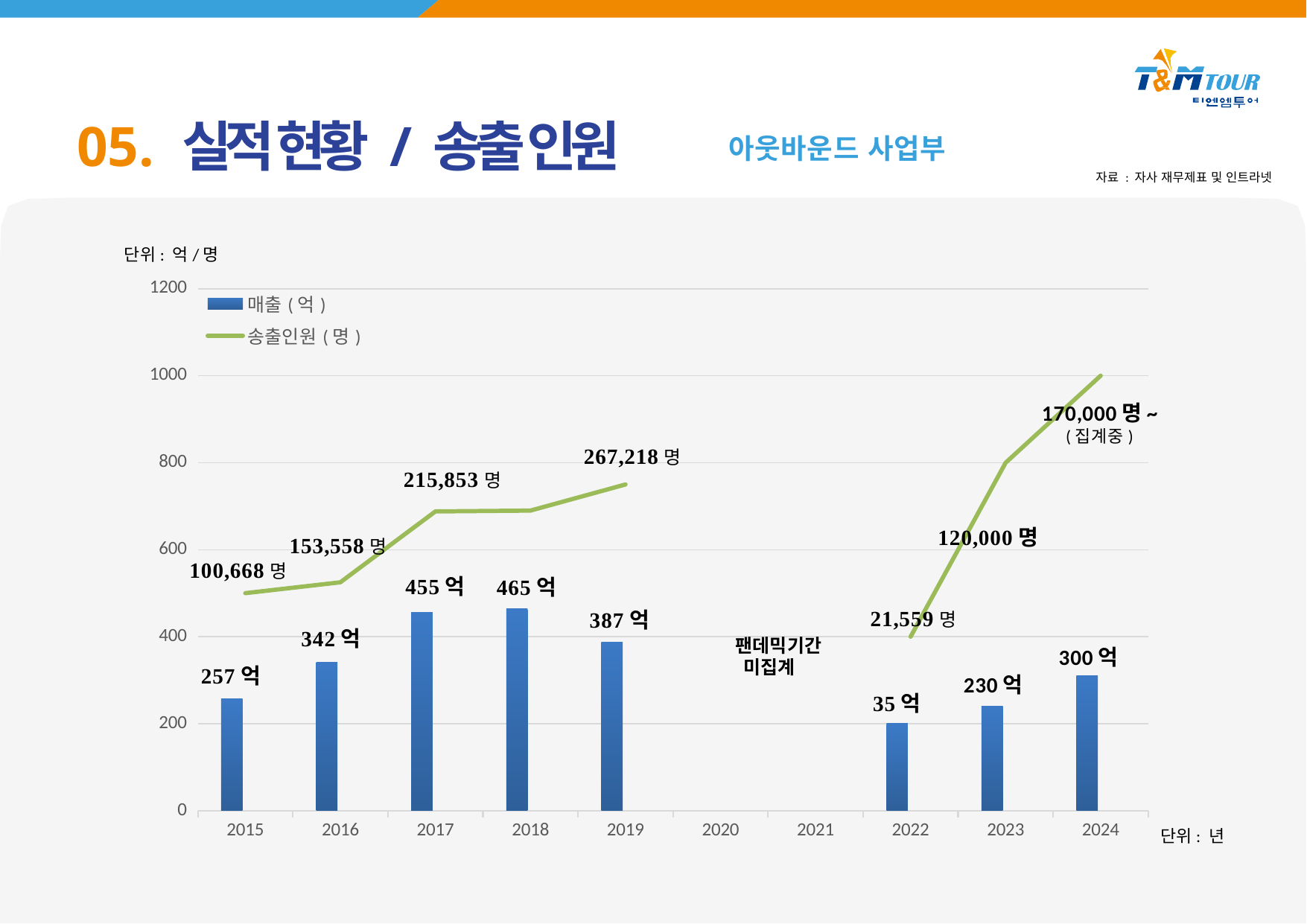
What is the 매출 (억) value for 2018? 465 억 How many series does the legend list? 2 Which year has the highest 매출 (억)? 2018 What is the 송출인원 (명) value for 2022? 21,559 명 Does 매출 (억) rise or fall from 2015 to 2018? Rise Which year has the lowest 매출 (억) among the years with a bar? 2022 What kind of chart is shown on the slide? Combined bar and line chart What is the 매출 (억) value for 2024? 300 억 How many years are shown on the x axis? 10 Which year has the larger 매출 (억), 2016 or 2019? 2019 What is the difference in 매출 (억) between 2024 and 2023? 70 억 What is the difference in 매출 (억) between 2018 and 2017? 10 억